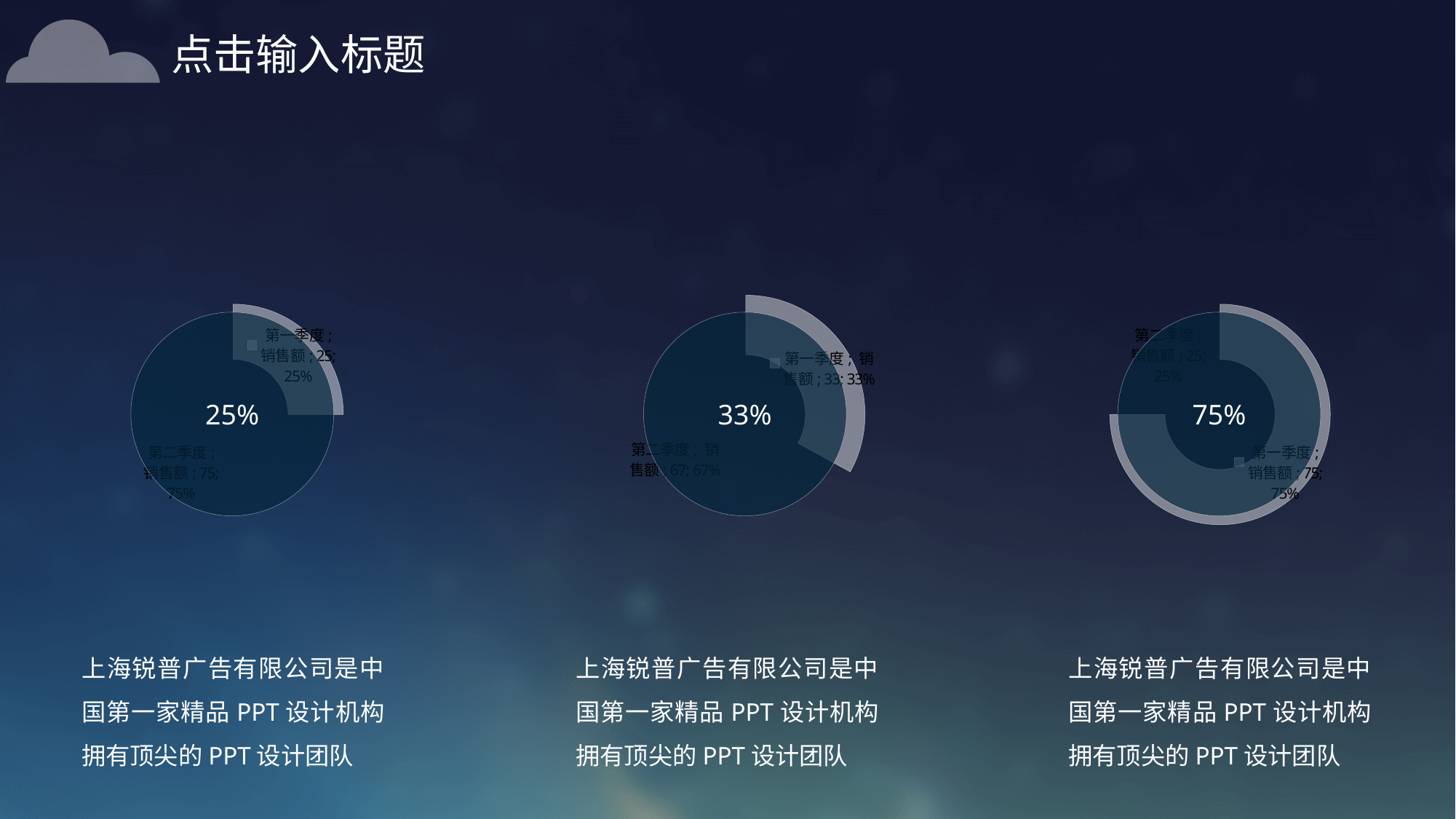
In the middle chart, what is the 销售额 value for 第二季度? 67 In the left chart, what percentage is shown in the centre? 25% How many charts are shown on the slide? 3 In the left chart, what is the 销售额 value for 第二季度? 75 What kind of chart is the left chart on the slide? doughnut chart In the left chart, which category has the larger value, 第一季度 or 第二季度? 第二季度 In the right chart, which category has the smallest value? 第二季度 In the right chart, what percentage is shown in the centre? 75% In the right chart, what share of the pie does 第一季度 take? 75% In the middle chart, what is the difference between the 第二季度 and 第一季度 values? 34 In the middle chart, what share of the pie does 第一季度 take? 33% In the middle chart, what percentage is shown in the centre? 33%